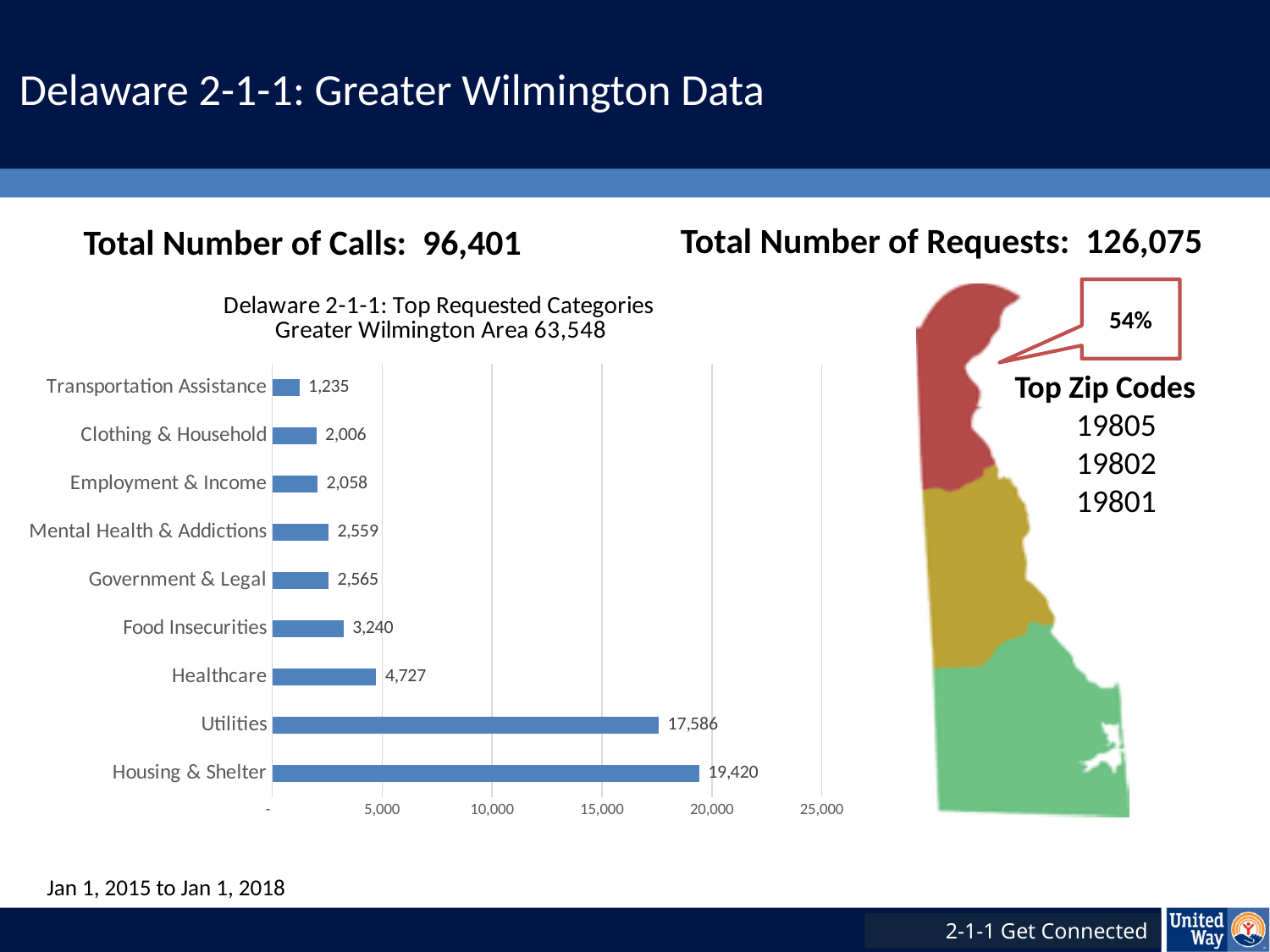
What is the title of the chart? Delaware 2-1-1: Top Requested Categories Greater Wilmington Area 63,548 What is the value for Healthcare? 4,727 What is the value for Transportation Assistance? 1,235 Is the value for Utilities greater or less than 15,000? greater Which is larger, Food Insecurities or Healthcare? Healthcare What is the value for Housing & Shelter? 19,420 What is the difference between Housing & Shelter and Utilities? 1,834 How many categories are shown in the chart? 9 What kind of chart is shown on the slide? bar chart What is the value for Utilities? 17,586 Which category has the highest value? Housing & Shelter Which category has the lowest value? Transportation Assistance